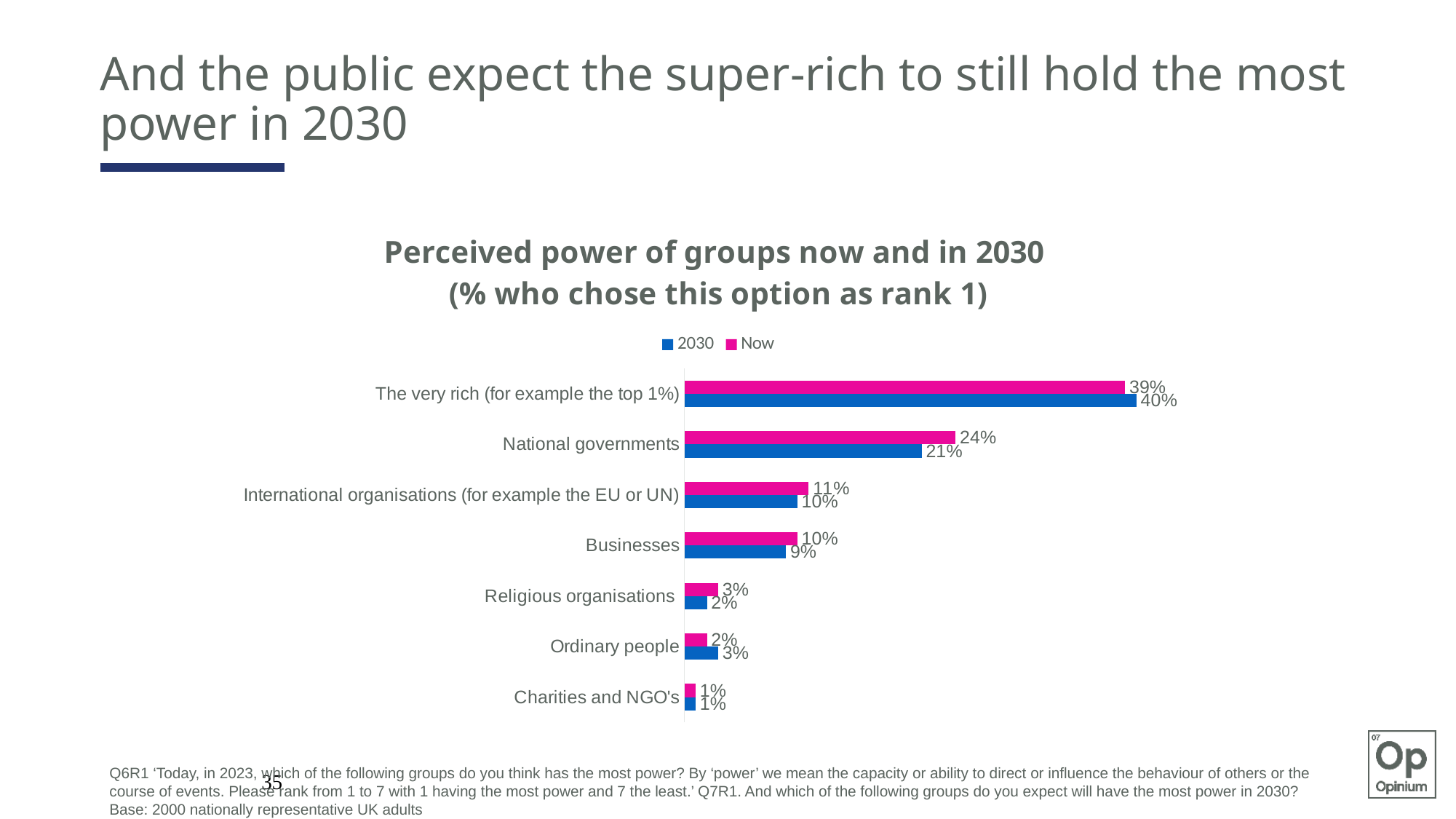
What is the 2030 value for National governments? 21% What is the 'Now' value for International organisations (for example the EU or UN)? 11% How many series does the legend list? 2 What is the 'Now' value for The very rich (for example the top 1%)? 39% Which group has the highest 2030 value? The very rich (for example the top 1%) What kind of chart is shown on the slide? Bar chart How many groups are shown on the chart? 7 For Businesses, which is larger: the 'Now' value or the 2030 value? Now Which group has the lowest 'Now' value? Charities and NGO's What is the 2030 value for Ordinary people? 3% Which colour represents the 2030 series in the legend? Blue What is the difference between the 'Now' and 2030 values for National governments? 3%